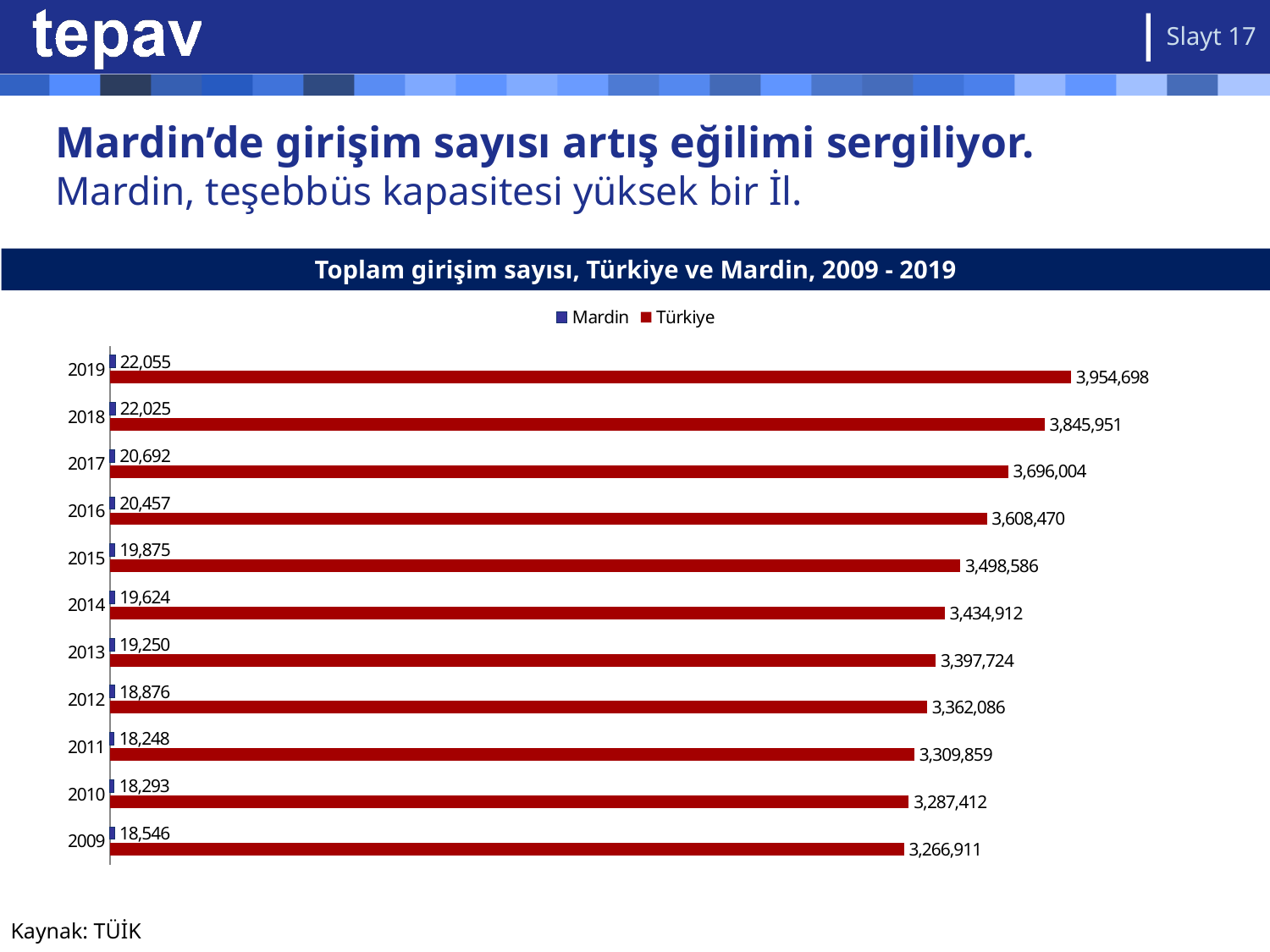
Do the Türkiye values rise or fall from 2009 to 2019? Rise What is the value for Türkiye in 2009? 3,266,911 What is the difference between the Türkiye values for 2019 and 2018? 108,747 Which is larger, the Mardin value for 2010 or for 2011? 2010 Which year has the highest value for Türkiye? 2019 What is the difference between the Mardin values for 2019 and 2009? 3,509 How many years are shown on the chart? 11 Which year has the lowest value for Mardin? 2011 What is the value for Mardin in 2014? 19,624 How many series does the legend list? 2 What kind of chart is shown on the slide? Bar chart What is the value for Mardin in 2019? 22,055